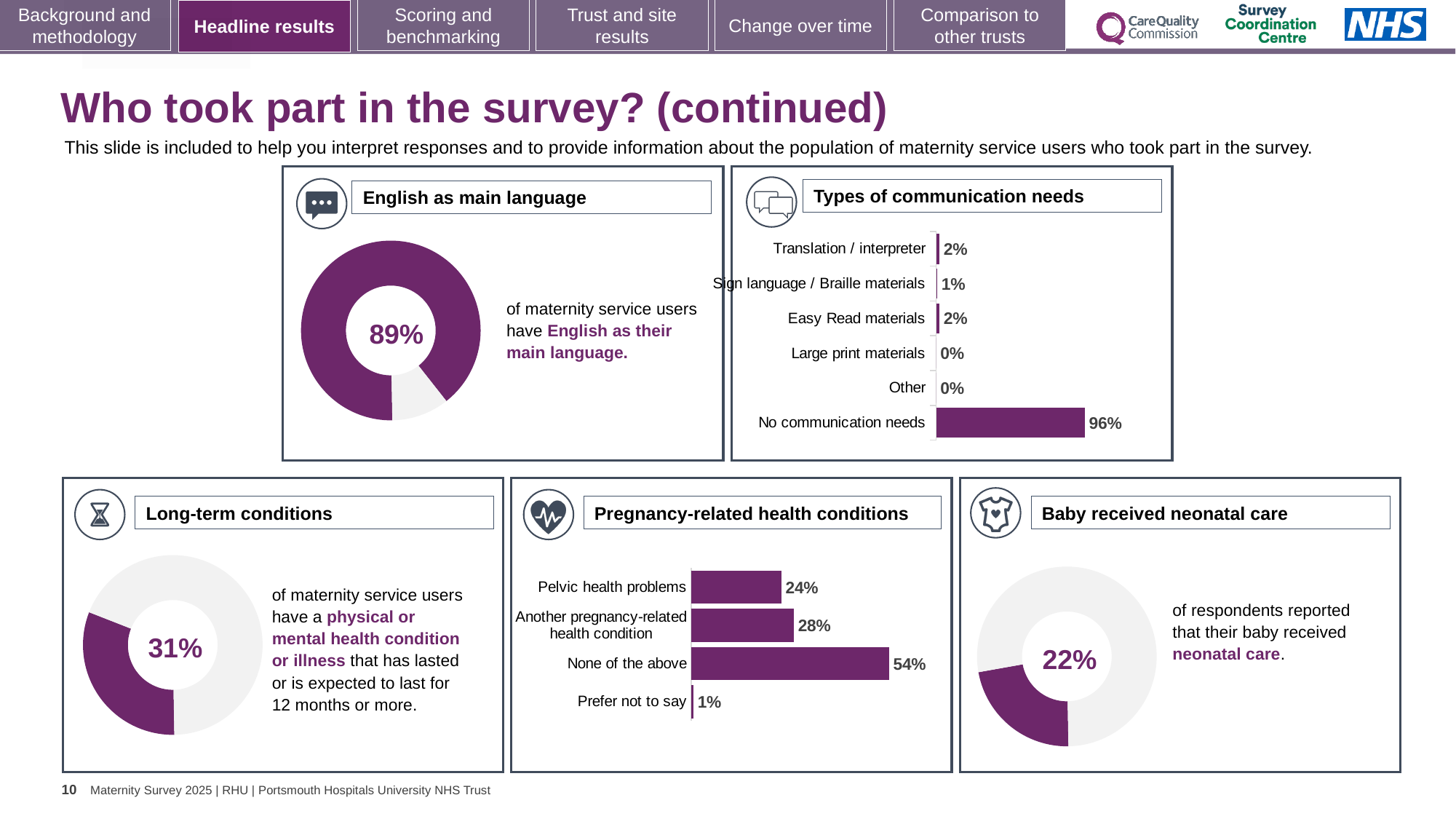
In the 'Pregnancy-related health conditions' chart, what is the value for Pelvic health problems? 24% In the 'Pregnancy-related health conditions' chart, what is the difference between None of the above and Another pregnancy-related health condition? 26% In the 'Types of communication needs' chart, what is the value for Translation / interpreter? 2% In the 'Types of communication needs' chart, how many categories are shown? 6 In the 'Long-term conditions' chart, what percentage is shown in the centre of the donut? 31% In the 'English as main language' chart, what percentage of maternity service users have English as their main language? 89% In the 'Pregnancy-related health conditions' chart, which is larger: Pelvic health problems or Another pregnancy-related health condition? Another pregnancy-related health condition In the 'Baby received neonatal care' chart, what percentage of respondents reported that their baby received neonatal care? 22% In the 'Types of communication needs' chart, which category has the highest value? No communication needs What kind of chart is used for 'Pregnancy-related health conditions'? Bar chart In the 'Types of communication needs' chart, what is the value for No communication needs? 96% In the 'Pregnancy-related health conditions' chart, which category has the lowest value? Prefer not to say